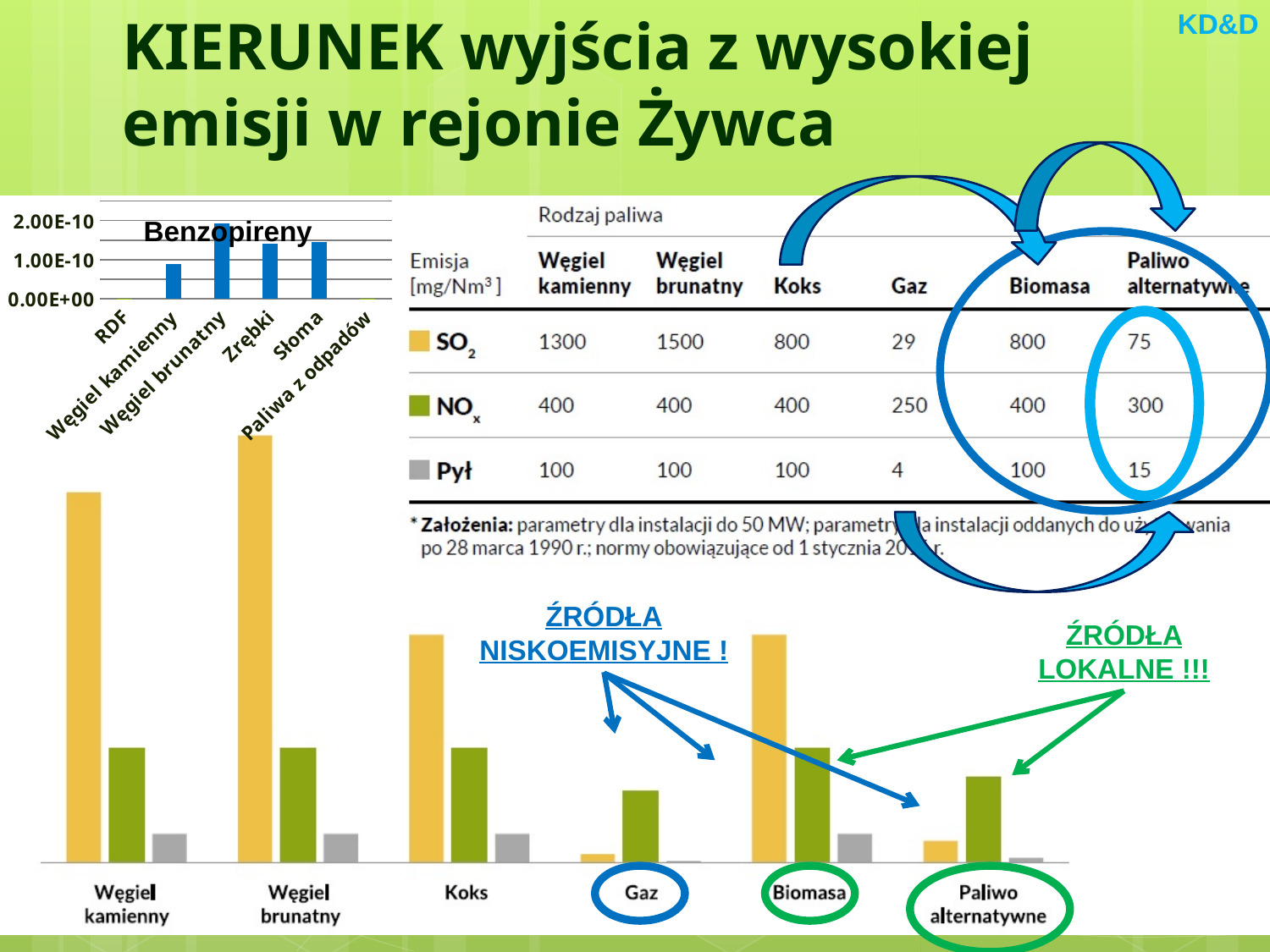
How many categories does the 'Benzopireny' chart show? 6 How many series (emission types) are plotted in the large bottom chart? 3 In the 'Benzopireny' chart, which category has the highest value? Węgiel brunatny What kind of chart is the small 'Benzopireny' chart at the top left of the slide? bar chart What kind of chart is the large chart at the bottom of the slide showing fuel types? bar chart In the 'Benzopireny' chart, is the value for Słoma greater or less than 1.00E-10? greater In the large bottom chart, which fuel has the tallest SO2 (yellow) bar? Węgiel brunatny How many fuel categories does the large bottom chart show? 6 In the 'Benzopireny' chart, is the value for Zrębki greater or less than 1.00E-10? greater In the large bottom chart, which is larger, the NOx (green) bar for Gaz or the NOx bar for Paliwo alternatywne? Paliwo alternatywne In the large bottom chart, which fuel has the shortest SO2 (yellow) bar? Gaz In the 'Benzopireny' chart, which is larger, the value for Węgiel kamienny or the value for Węgiel brunatny? Węgiel brunatny